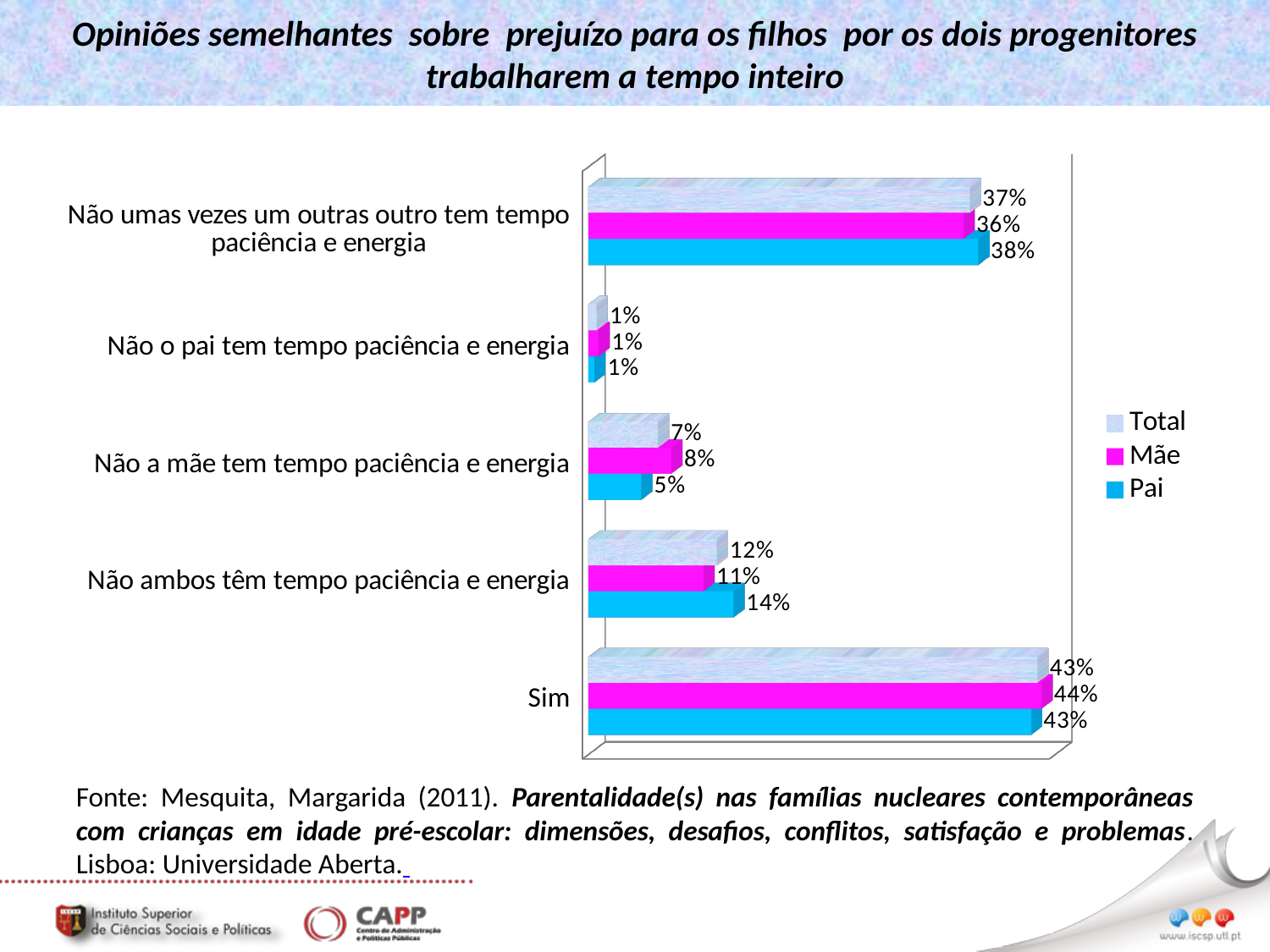
Which series is shown in magenta? Mãe For "Não a mãe tem tempo paciência e energia", which is larger, the Mãe value or the Pai value? Mãe What is the difference between the Pai and Mãe values for "Não umas vezes um outras outro tem tempo paciência e energia"? 2% How many series does the legend list? 3 How many categories are shown on the chart? 5 What kind of chart is shown on the slide? Bar chart What is the value for Mãe in the "Não ambos têm tempo paciência e energia" category? 11% What is the Total value for "Não a mãe tem tempo paciência e energia"? 7% Which category has the highest value for the Mãe series? Sim What is the value for Pai in the "Sim" category? 43% What is the difference between the Pai and Mãe values for "Não ambos têm tempo paciência e energia"? 3% Which category has the lowest value for the Pai series? Não o pai tem tempo paciência e energia